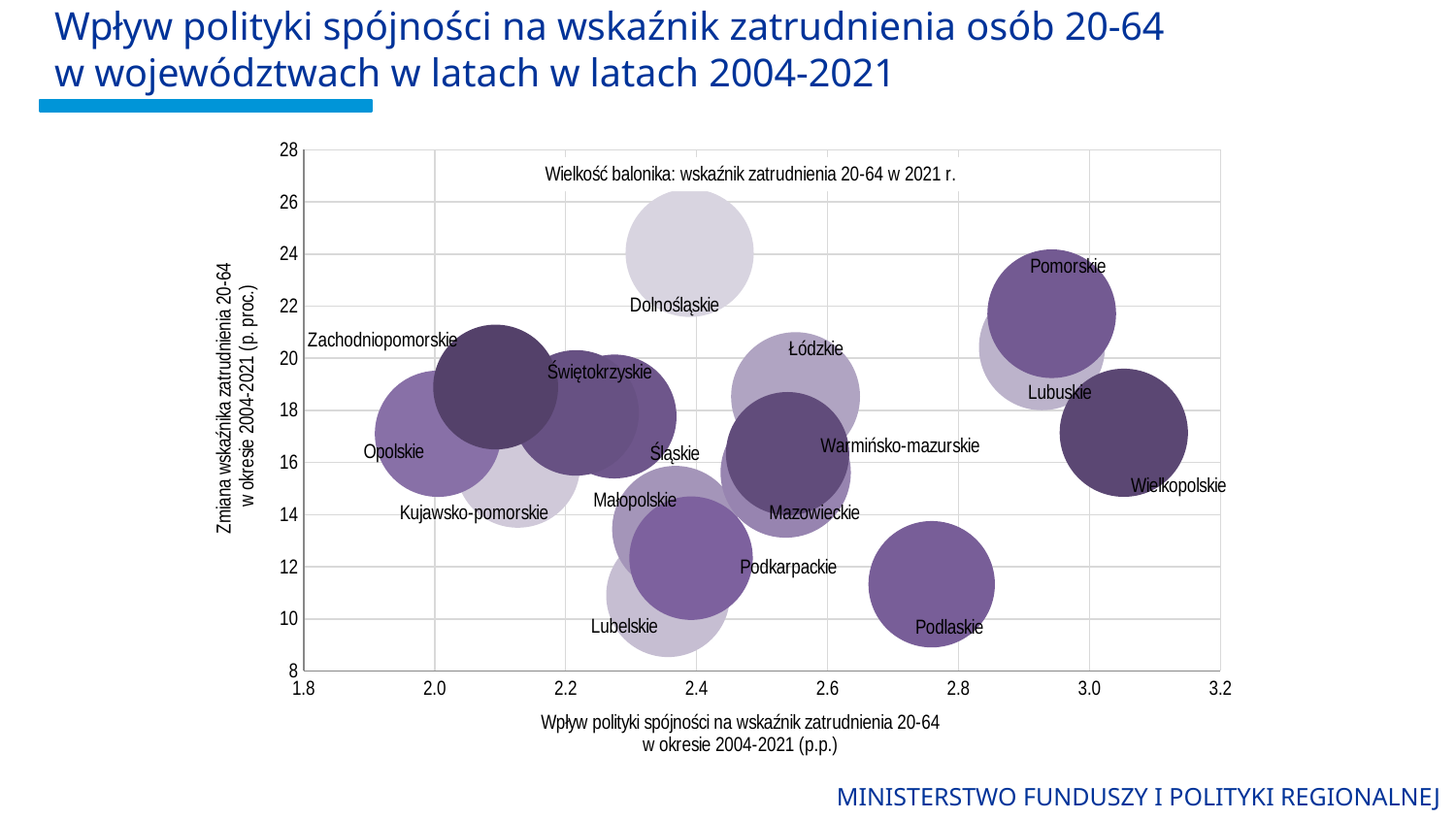
How many voivodeships (bubbles) are plotted on the chart? 16 Is the horizontal-axis value for Opolskie greater or less than 2.2? less What kind of chart is shown on the slide? Bubble chart According to the note on the chart, what does the bubble size represent? Wskaźnik zatrudnienia 20-64 w 2021 r. Is the vertical-axis value for Dolnośląskie greater or less than 22? greater Which voivodeship has the lowest value on the horizontal axis (impact of cohesion policy)? Opolskie Which voivodeship has the highest value on the horizontal axis (impact of cohesion policy)? Wielkopolskie Is the vertical-axis value for Podlaskie greater or less than 14? less Which voivodeship has the highest change in the employment rate (vertical axis)? Dolnośląskie What is the label of the horizontal axis? Wpływ polityki spójności na wskaźnik zatrudnienia 20-64 w okresie 2004-2021 (p.p.) Which has a higher change in the employment rate (vertical axis): Pomorskie or Podkarpackie? Pomorskie